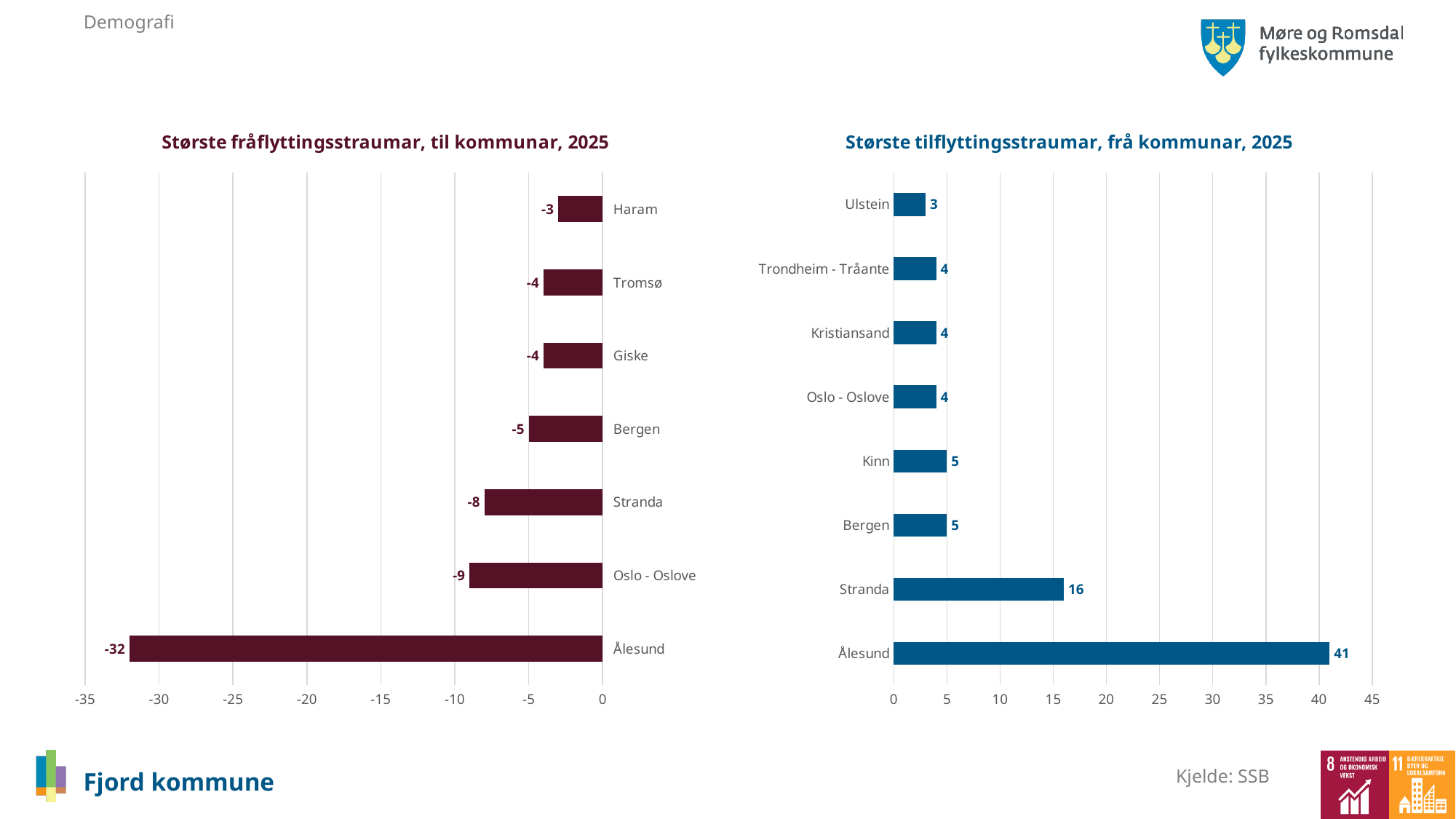
How many categories are shown in the chart 'Største tilflyttingsstraumar, frå kommunar, 2025'? 8 What kind of chart is 'Største tilflyttingsstraumar, frå kommunar, 2025'? Bar chart In the chart 'Største fråflyttingsstraumar, til kommunar, 2025', what is the value for Ålesund? -32 In the chart 'Største tilflyttingsstraumar, frå kommunar, 2025', which category has the highest value? Ålesund How many categories are shown in the chart 'Største fråflyttingsstraumar, til kommunar, 2025'? 7 In the chart 'Største tilflyttingsstraumar, frå kommunar, 2025', what is the value for Ulstein? 3 In the chart 'Største fråflyttingsstraumar, til kommunar, 2025', which category has the lowest (most negative) value? Ålesund In the chart 'Største tilflyttingsstraumar, frå kommunar, 2025', what is the value for Stranda? 16 In the chart 'Største tilflyttingsstraumar, frå kommunar, 2025', which is larger, the value for Kinn or the value for Ulstein? Kinn In the chart 'Største tilflyttingsstraumar, frå kommunar, 2025', what is the difference between the values for Ålesund and Stranda? 25 In the chart 'Største fråflyttingsstraumar, til kommunar, 2025', what is the value for Stranda? -8 In the chart 'Største fråflyttingsstraumar, til kommunar, 2025', what is the difference between the values for Oslo - Oslove and Bergen? 4